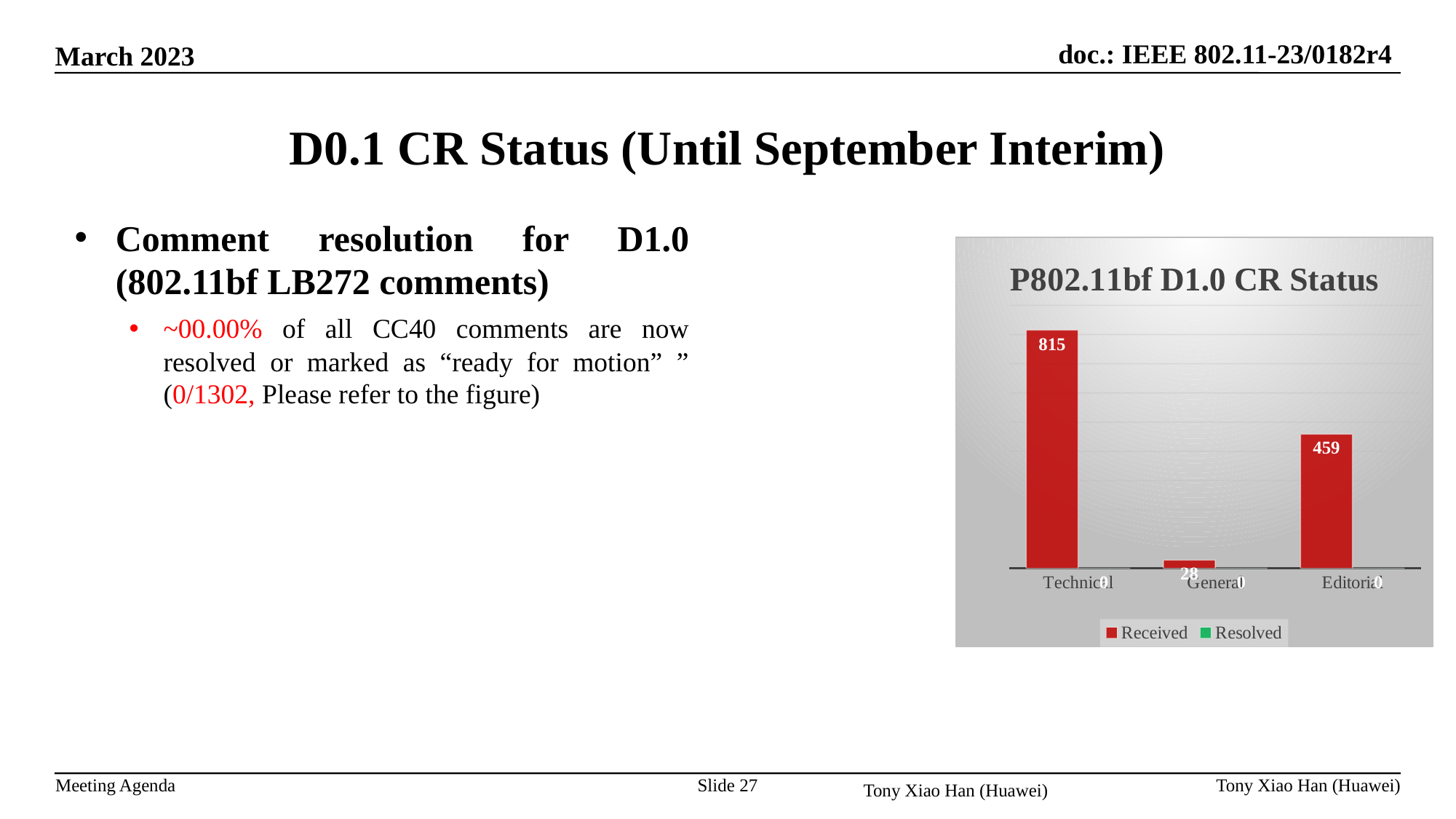
Which category has the lowest Received value? General What kind of chart is shown on the slide? bar chart What is the title of the chart? P802.11bf D1.0 CR Status Which is larger, the Received value for Editorial or for General? Editorial Which category has the highest Received value? Technical What is the Received value for Technical? 815 How many series does the chart legend list? 2 How many categories are shown on the x axis of the chart? 3 What is the Received value for General? 28 What is the Received value for Editorial? 459 What is the difference between the Received values for Technical and Editorial? 356 Which series is shown in red in the chart legend? Received